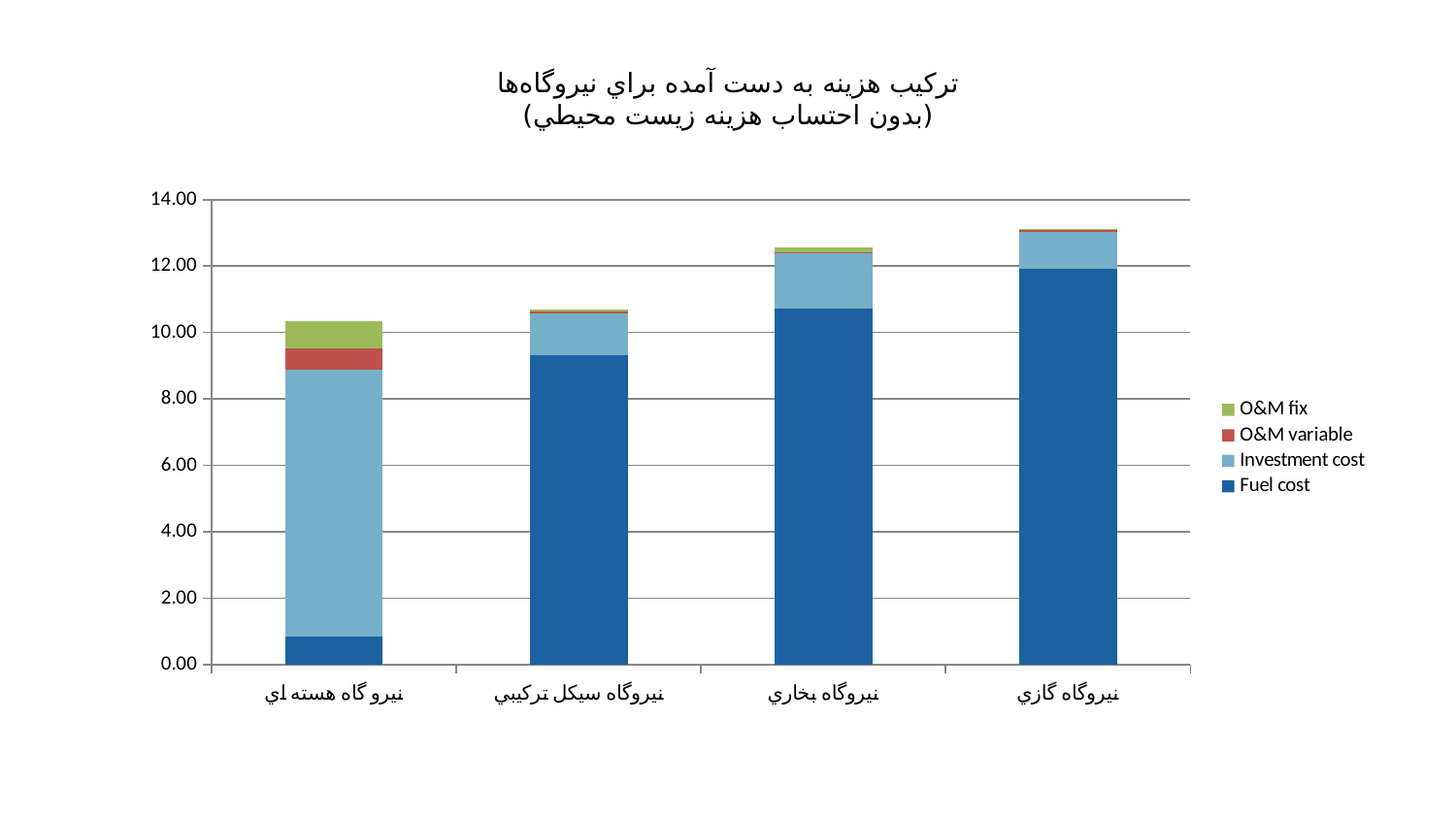
How many series does the legend list? 4 Is the total stacked value for نیروگاه بخاري greater or less than 12.00? greater Which category has the tallest stacked bar overall? نیروگاه گازي Is the Fuel cost value for نیرو گاه هسته اي greater or less than 2.00? less What kind of chart is shown on the slide? Stacked bar chart Is the Fuel cost value for نیروگاه گازي greater or less than 10.00? greater Which has a larger Fuel cost: نیرو گاه هسته اي or نیروگاه گازي? نیروگاه گازي Which series is shown in green in the legend? O&M fix How many categories (power plant types) are shown on the x axis? 4 Which category has the shortest stacked bar overall? نیرو گاه هسته اي Which category has the largest Investment cost segment? نیرو گاه هسته اي